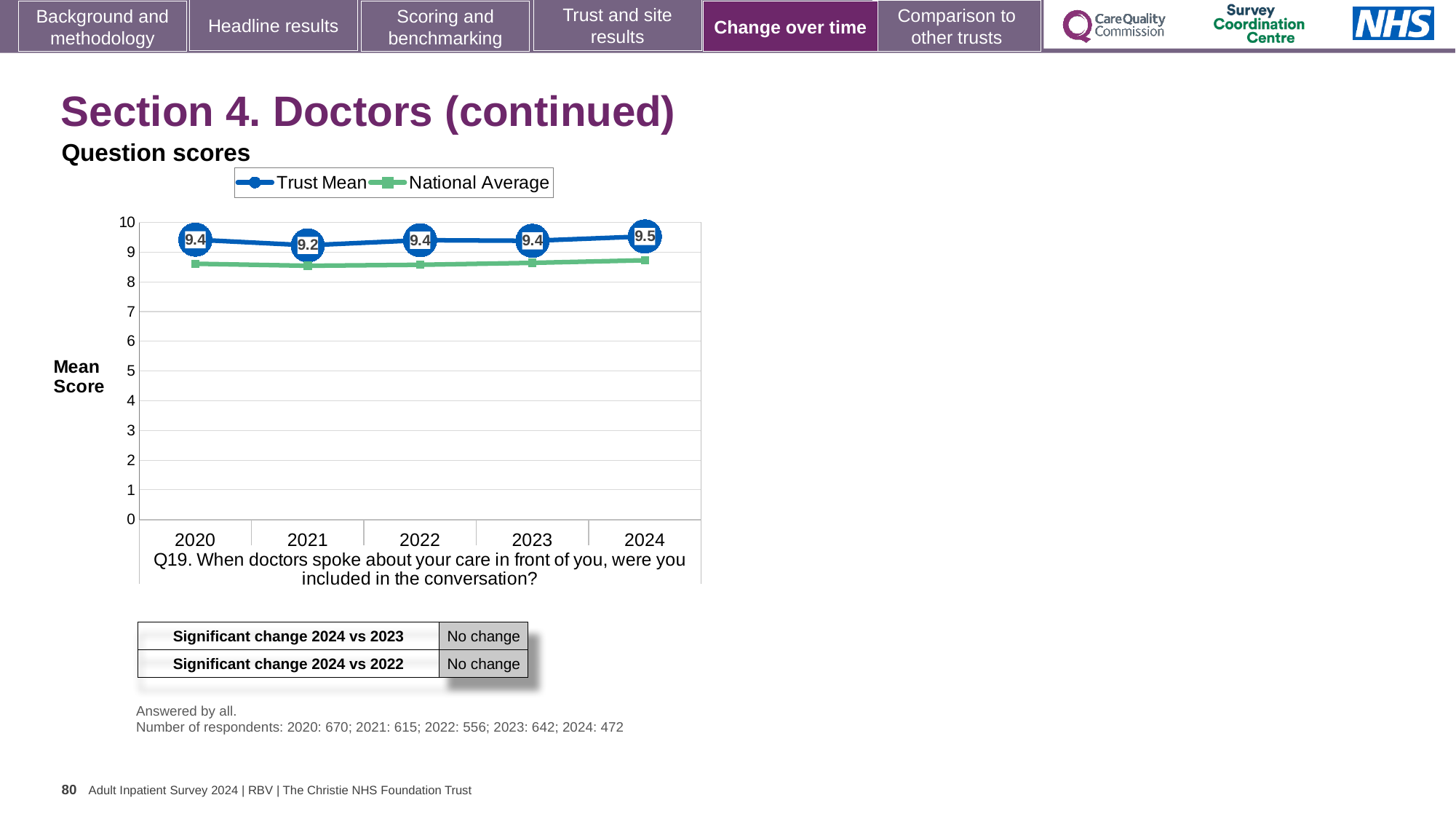
What is the Trust Mean score for 2021? 9.2 Is the National Average for 2020 greater or less than 8? greater Is the Trust Mean score for 2022 greater or less than the National Average for 2022? greater In which year is the Trust Mean score highest? 2024 What is the difference between the Trust Mean score in 2024 and in 2021? 0.3 In which year is the Trust Mean score lowest? 2021 How many series does the legend list? 2 What kind of chart is shown? Line chart How many years are plotted on the x axis? 5 What is the Trust Mean score for 2020? 9.4 What is the Trust Mean score for 2024? 9.5 Is the National Average for 2024 greater or less than 9? less